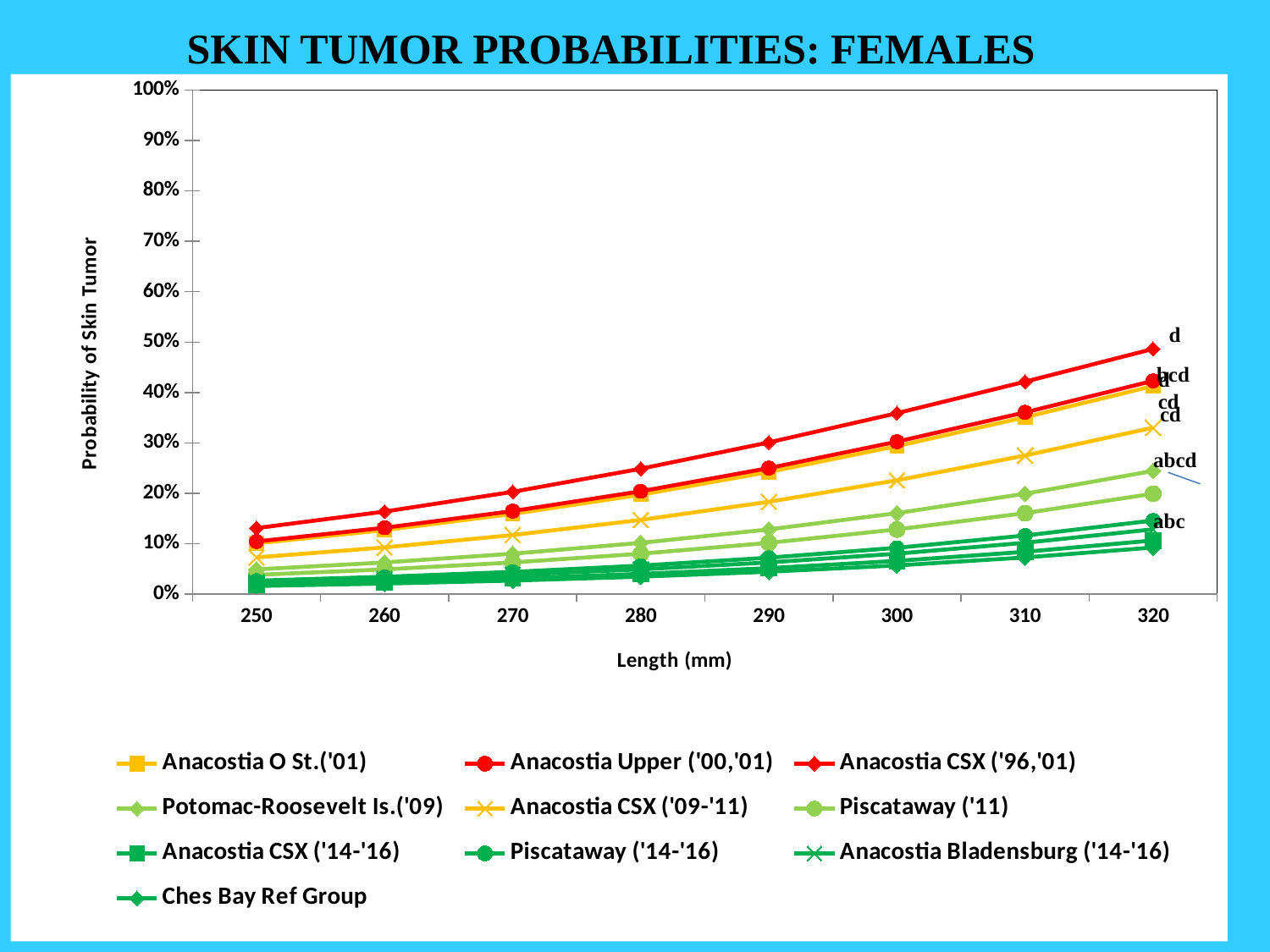
Is the value for Potomac-Roosevelt Is.('09) at 320 mm greater or less than 20%? greater Is the value for Anacostia CSX ('96,'01) at 250 mm greater or less than 20%? less How many series does the legend list? 10 Do the probabilities rise or fall as length increases from 250 mm to 320 mm? rise What is the title of the chart? SKIN TUMOR PROBABILITIES: FEMALES What is the label of the x axis? Length (mm) Which series has the highest probability of skin tumor at 320 mm? Anacostia CSX ('96,'01) Is the value for Anacostia CSX ('09-'11) at 320 mm greater or less than 30%? greater What kind of chart is shown on the slide? line chart How many length values are plotted along the x axis? 8 At 320 mm, which is larger: Anacostia CSX ('96,'01) or Anacostia CSX ('09-'11)? Anacostia CSX ('96,'01)